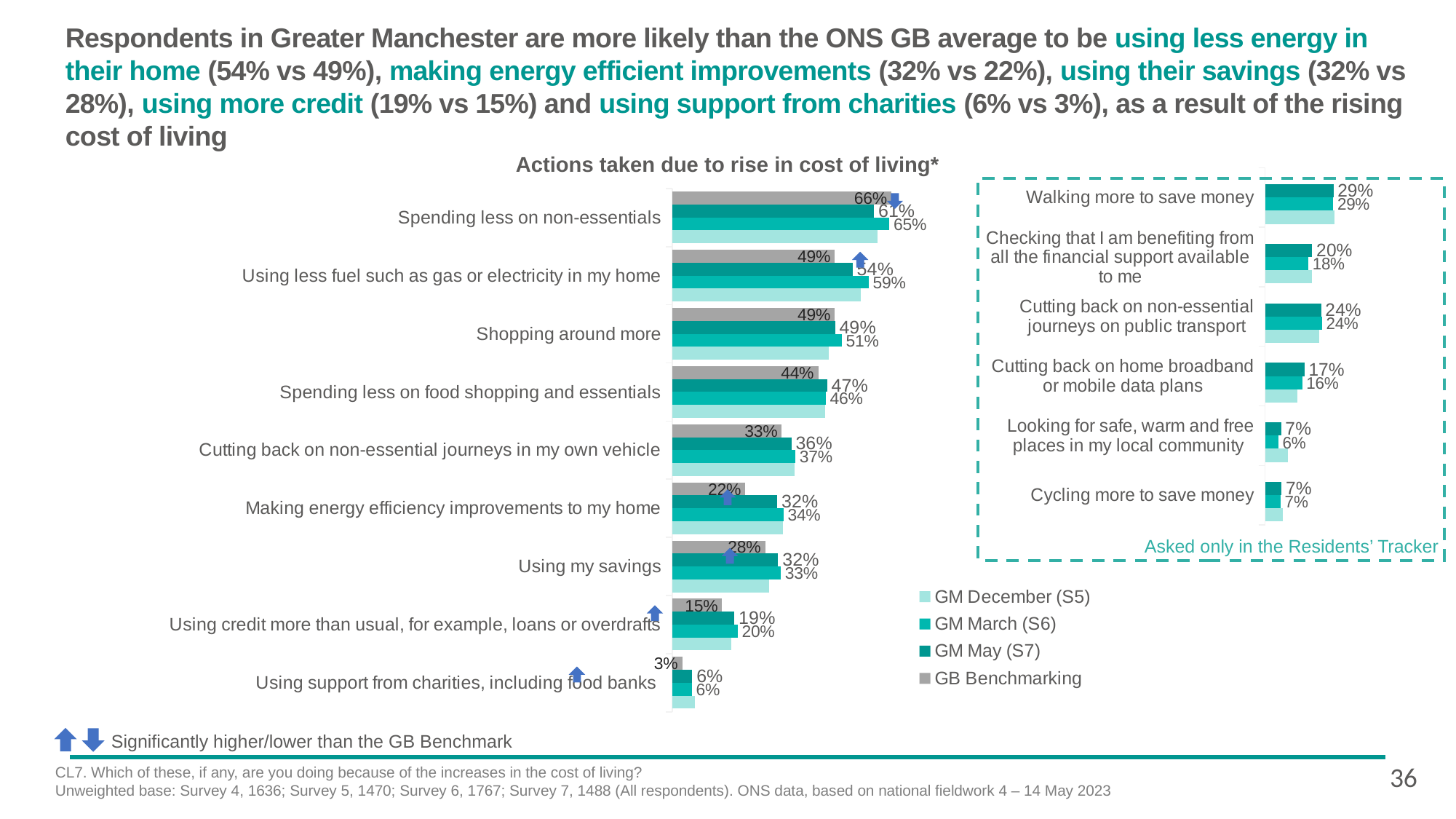
In the chart on the right (Asked only in the Residents' Tracker), which category has the highest GM May (S7) value? Walking more to save money In the 'Actions taken due to rise in cost of living' chart, what is the difference between the GM May (S7) and GB Benchmarking values for 'Making energy efficiency improvements to my home'? 10 percentage points In the 'Actions taken due to rise in cost of living' chart, which category has the lowest GB Benchmarking value? Using support from charities, including food banks In the 'Actions taken due to rise in cost of living' chart, what is the GM May (S7) value for 'Using less fuel such as gas or electricity in my home'? 54% How many categories are shown in the 'Actions taken due to rise in cost of living' chart? 9 What type of chart is the 'Actions taken due to rise in cost of living' chart? Bar chart In the 'Actions taken due to rise in cost of living' chart, which is larger for 'Using my savings': the GM May (S7) value or the GB Benchmarking value? GM May (S7) In the 'Actions taken due to rise in cost of living' chart, what is the GB Benchmarking value for 'Spending less on non-essentials'? 66% In the 'Actions taken due to rise in cost of living' chart, what is the GM March (S6) value for 'Making energy efficiency improvements to my home'? 34% In the 'Actions taken due to rise in cost of living' chart, which category has the highest GM May (S7) value? Spending less on non-essentials How many series does the legend of the 'Actions taken due to rise in cost of living' chart list? 4 In the chart on the right (Asked only in the Residents' Tracker), what is the GM May (S7) value for 'Cutting back on non-essential journeys on public transport'? 24%